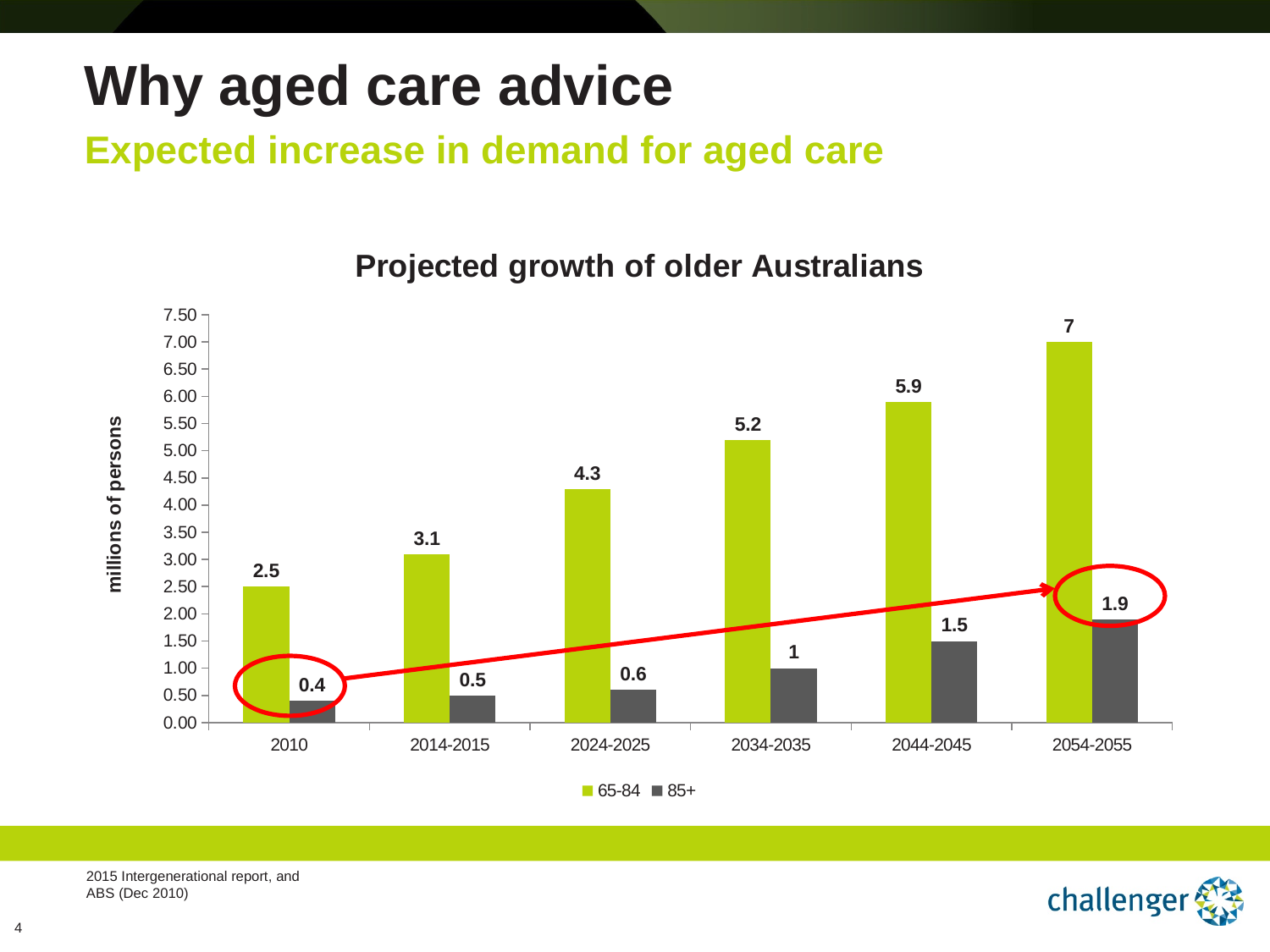
What is the value for the 85+ series in 2010? 0.4 What is the value for the 85+ series in 2044-2045? 1.5 Which period has the highest value for the 65-84 series? 2054-2055 What is the value for the 65-84 series in 2024-2025? 4.3 Which is larger: the 85+ value in 2034-2035 or the 85+ value in 2024-2025? 2034-2035 Which period has the lowest value for the 85+ series? 2010 What kind of chart is shown? bar chart How many series does the legend list? 2 How many periods are shown on the x axis? 6 Is the value for the 65-84 series in 2044-2045 greater or less than 5.00? greater What is the difference between the 65-84 values for 2054-2055 and 2010? 4.5 Do the values for the 85+ series rise or fall from 2010 to 2054-2055? rise